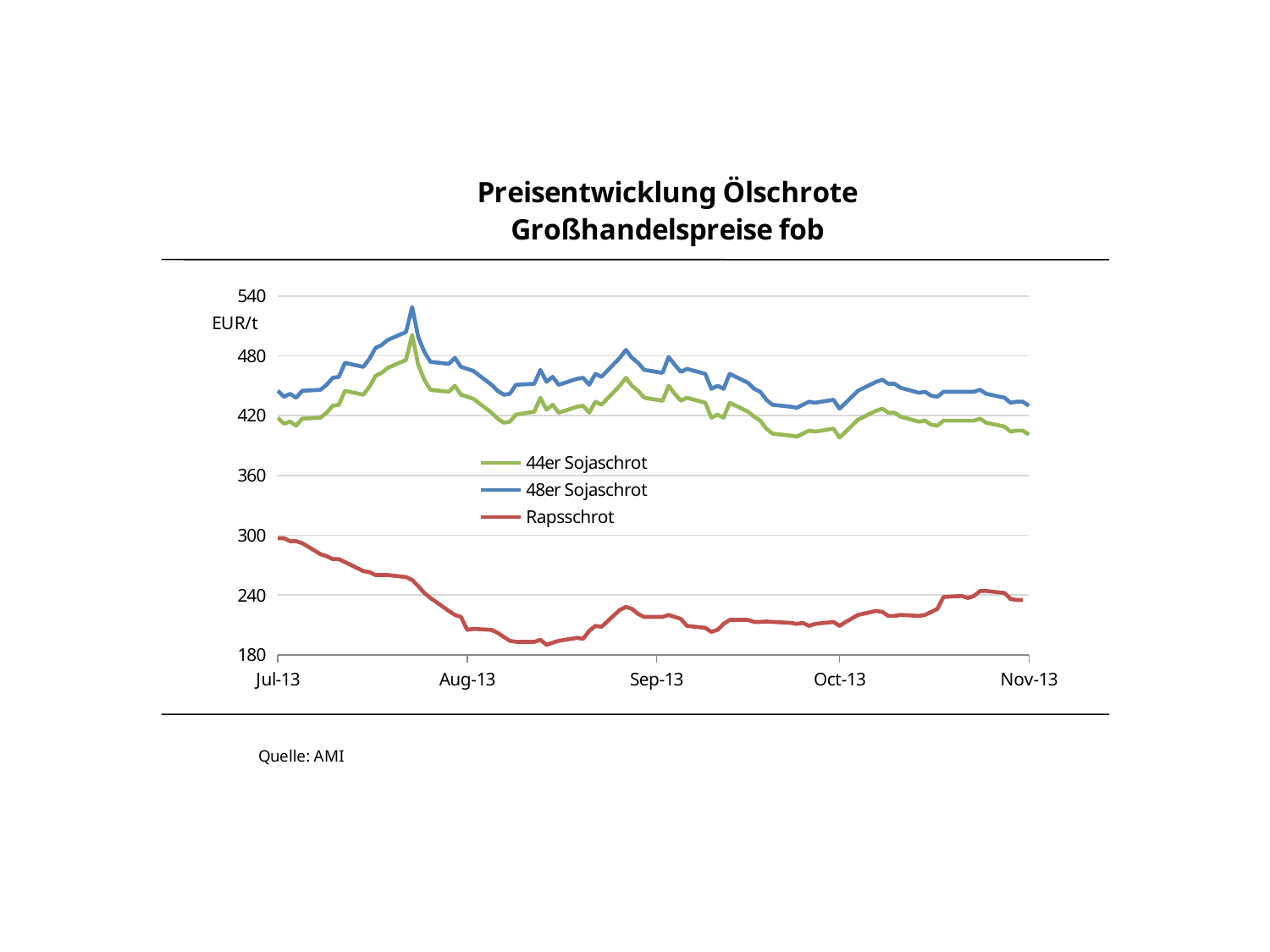
What unit is shown on the vertical axis of the chart? EUR/t At Aug-13, which is larger: 48er Sojaschrot or 44er Sojaschrot? 48er Sojaschrot What kind of chart is shown on the slide? line chart What is the title of the chart? Preisentwicklung Ölschrote Großhandelspreise fob Does the Rapsschrot price rise or fall between Jul-13 and Aug-13? fall Which series has the lowest values throughout the chart? Rapsschrot Is the value for Rapsschrot at Sep-13 greater or less than 240? less Is the peak value of 48er Sojaschrot in late July 2013 greater or less than 480? greater Is the value for Rapsschrot at Aug-13 greater or less than 240? less Which series has the highest values throughout the chart? 48er Sojaschrot How many series does the legend list? 3